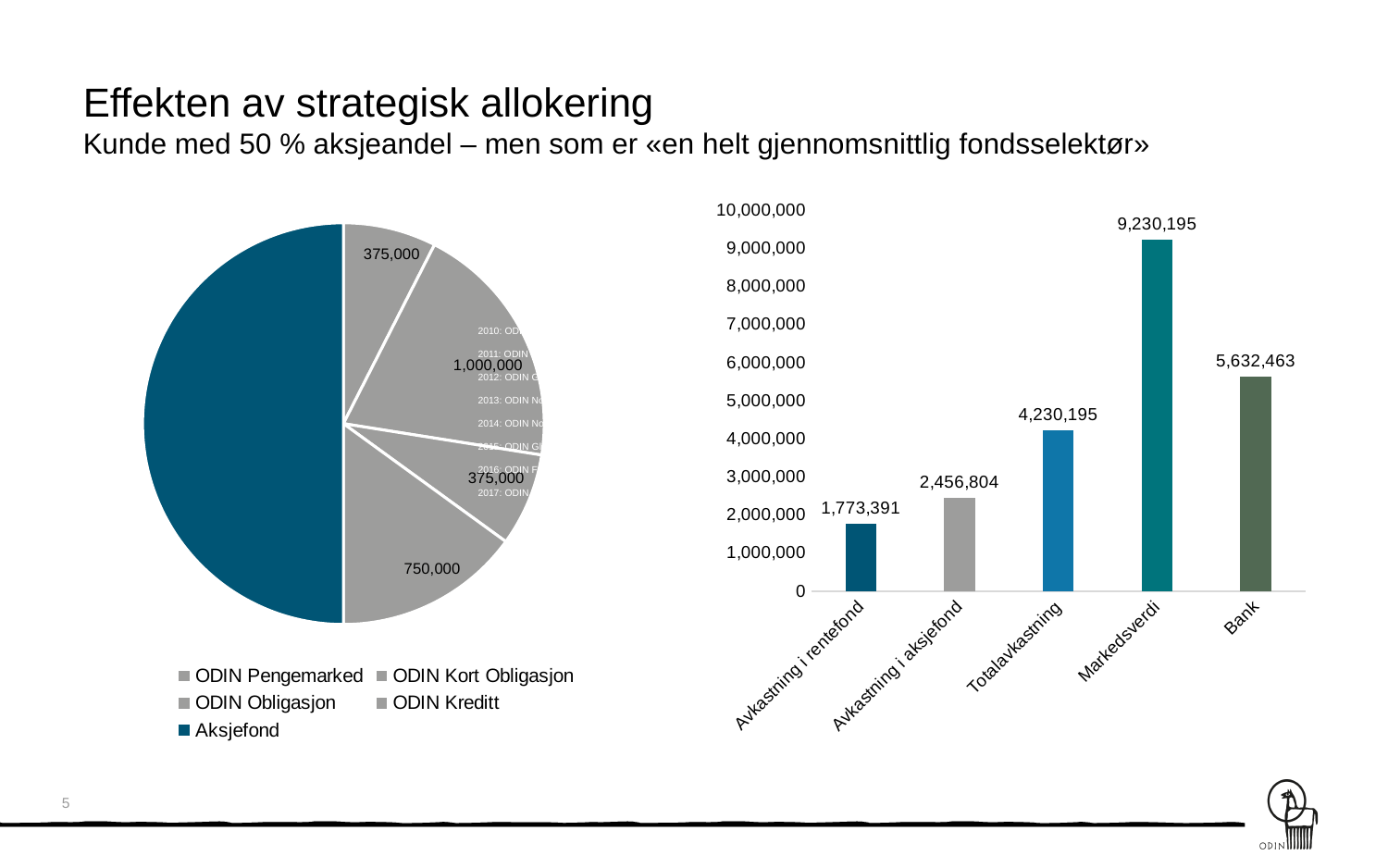
On the bar chart on the right, which category has the lowest value? Avkastning i rentefond On the bar chart on the right, how many categories are shown? 5 On the pie chart on the left, which legend entry corresponds to the largest slice? Aksjefond On the bar chart on the right, what is the difference between Avkastning i aksjefond and Avkastning i rentefond? 683,413 On the bar chart on the right, which category has the highest value? Markedsverdi On the bar chart on the right, what is the value for Avkastning i rentefond? 1,773,391 What type of chart is shown on the right side of the slide? Bar chart On the bar chart on the right, what is the value for Bank? 5,632,463 How many entries does the legend of the pie chart on the left list? 5 On the bar chart on the right, what is the difference between Markedsverdi and Bank? 3,597,732 On the bar chart on the right, which is larger: Totalavkastning or Bank? Bank On the bar chart on the right, what is the value for Markedsverdi? 9,230,195